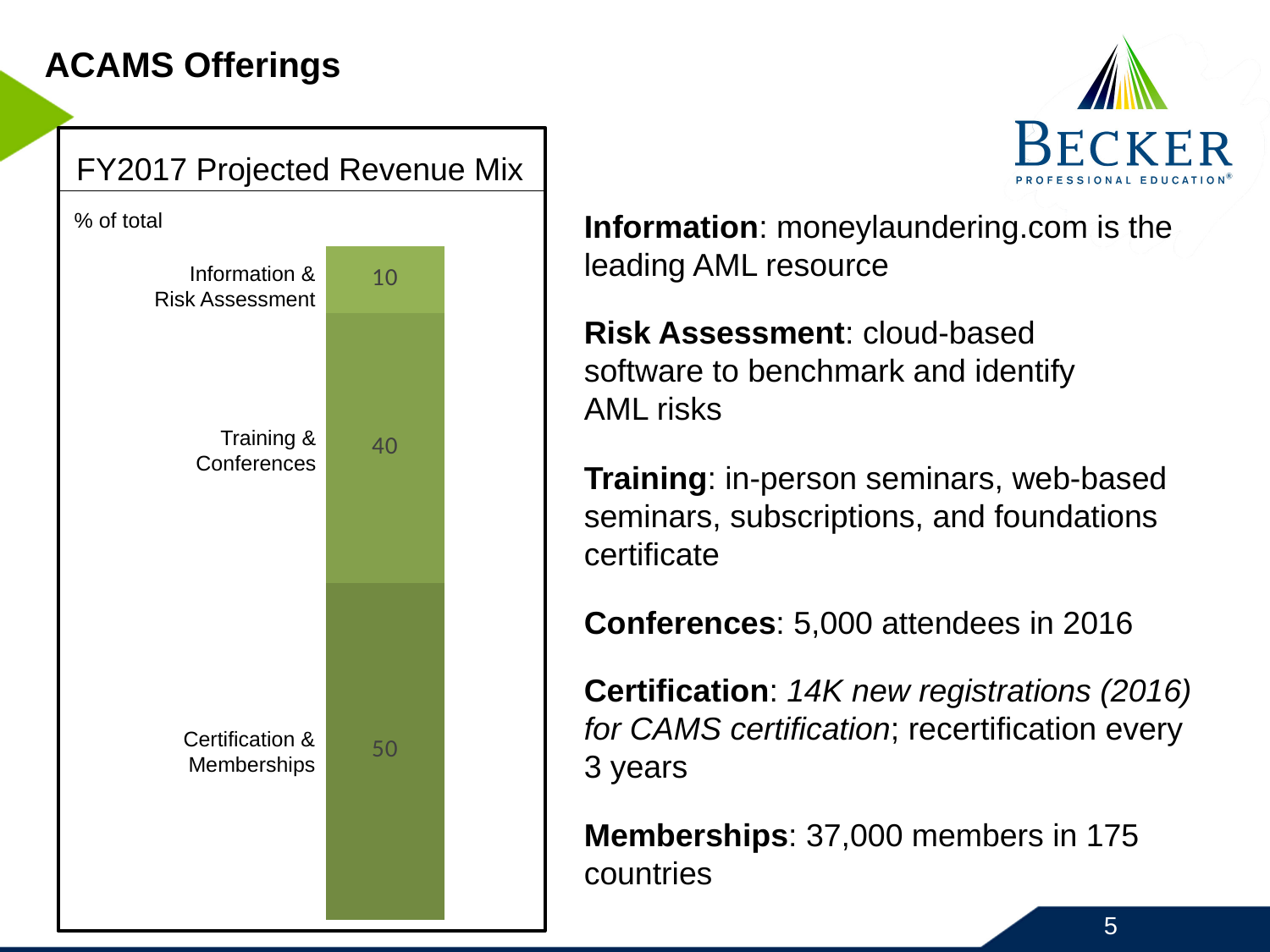
What is the title of the chart on the slide? FY2017 Projected Revenue Mix What is the difference between the Certification & Memberships value and the Training & Conferences value? 10 Which is larger, Training & Conferences or Information & Risk Assessment? Training & Conferences What is the total of the stacked bar in the FY2017 Projected Revenue Mix chart? 100 What is the value for Certification & Memberships in the FY2017 Projected Revenue Mix chart? 50 What is the value for Training & Conferences in the FY2017 Projected Revenue Mix chart? 40 What kind of chart is shown on the slide? Stacked bar chart Which segment has the smallest share of the FY2017 Projected Revenue Mix? Information & Risk Assessment Which segment has the largest share of the FY2017 Projected Revenue Mix? Certification & Memberships What is the difference between the Training & Conferences value and the Information & Risk Assessment value? 30 How many segments make up the stacked bar in the FY2017 Projected Revenue Mix chart? 3 What is the value for Information & Risk Assessment in the FY2017 Projected Revenue Mix chart? 10